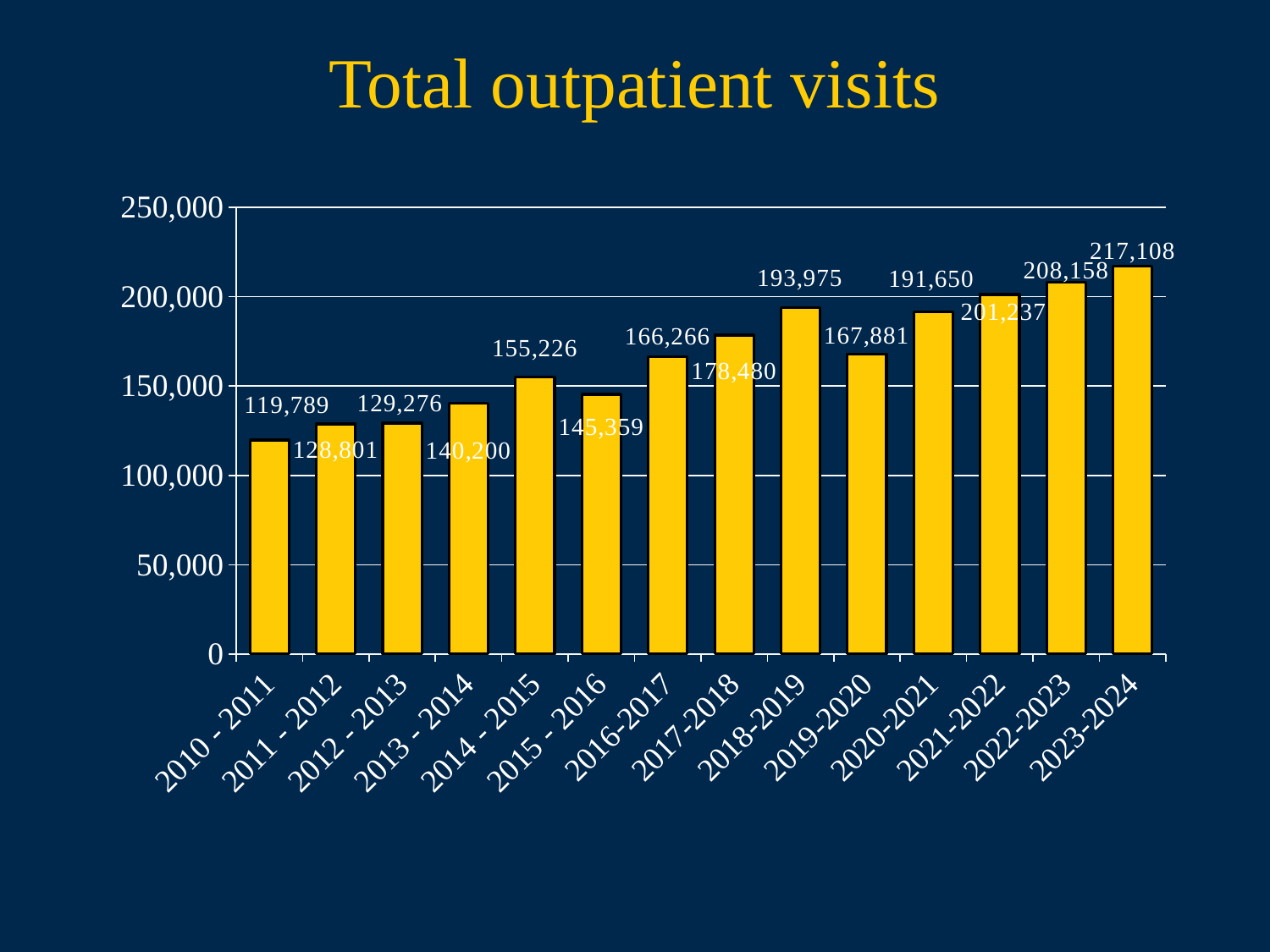
Do the values generally rise or fall from 2010 - 2011 to 2023-2024? Rise Which is larger, the value for 2014 - 2015 or 2015 - 2016? 2014 - 2015 What is the value for 2023-2024? 217,108 How many years are shown on the x axis? 14 What is the value for 2010 - 2011? 119,789 Which year has the lowest total outpatient visits? 2010 - 2011 What kind of chart is shown on the slide? Bar chart What is the difference between the values for 2023-2024 and 2010 - 2011? 97,319 Which year has the highest total outpatient visits? 2023-2024 Is the value for 2017-2018 greater or less than 150,000? greater What is the difference between the values for 2018-2019 and 2019-2020? 26,094 What is the value for 2018-2019? 193,975